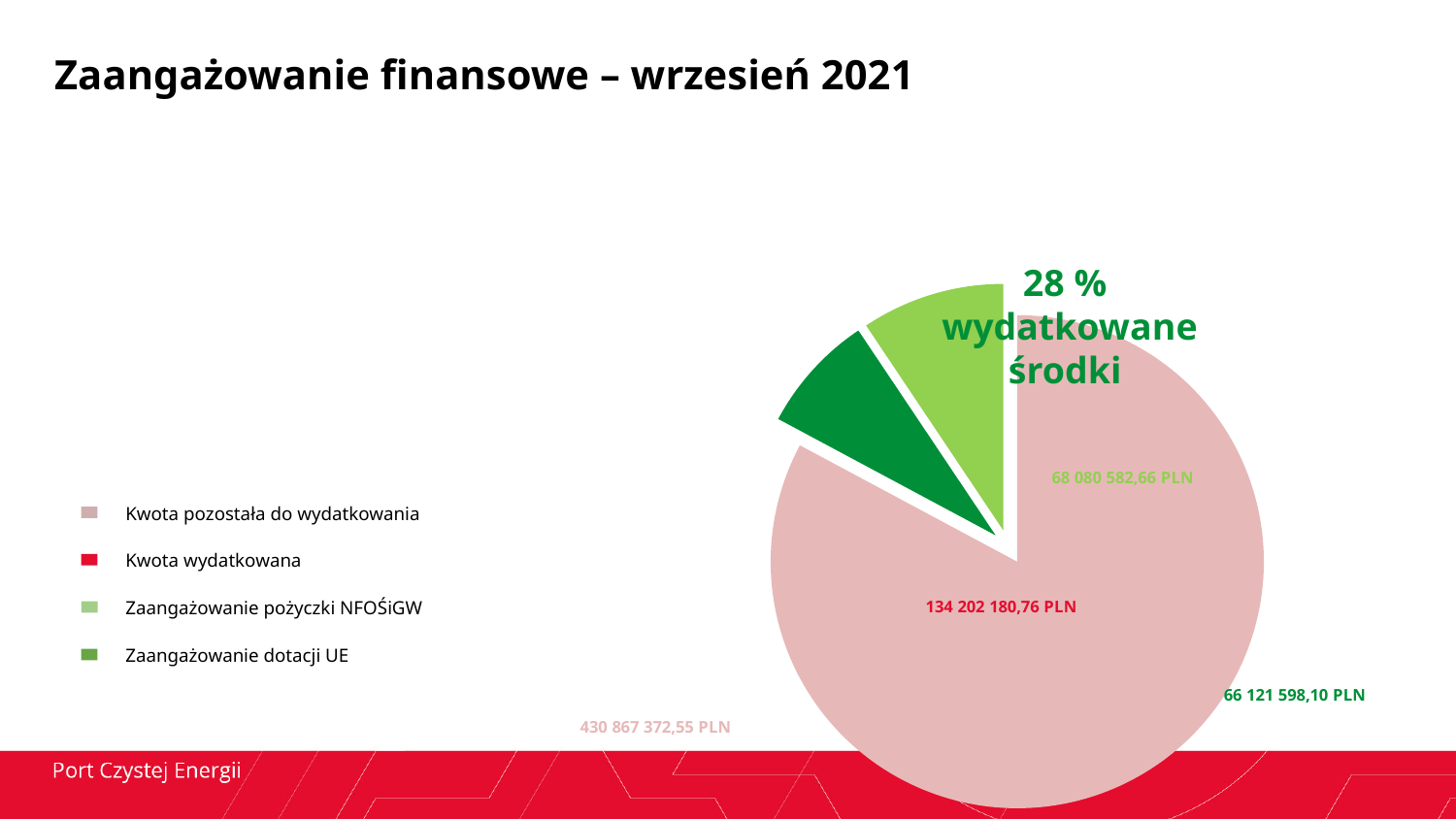
How many categories does the legend of the pie chart list? 4 What is the title of the slide containing the pie chart? Zaangażowanie finansowe – wrzesień 2021 What kind of chart is shown on the slide? pie chart Which is larger: Zaangażowanie pożyczki NFOŚiGW or Zaangażowanie dotacji UE? Zaangażowanie pożyczki NFOŚiGW What is the difference between the values for Zaangażowanie pożyczki NFOŚiGW and Zaangażowanie dotacji UE? 1 958 984,56 PLN What is the value shown for Kwota pozostała do wydatkowania? 430 867 372,55 PLN Which category has the smallest value in the pie chart? Zaangażowanie dotacji UE What is the value shown for Zaangażowanie pożyczki NFOŚiGW? 68 080 582,66 PLN What is the value shown for Kwota wydatkowana? 134 202 180,76 PLN What percentage of funds is stated as spent (wydatkowane środki) in the annotation next to the pie chart? 28 % Which category has the largest value in the pie chart? Kwota pozostała do wydatkowania What is the value shown for Zaangażowanie dotacji UE? 66 121 598,10 PLN